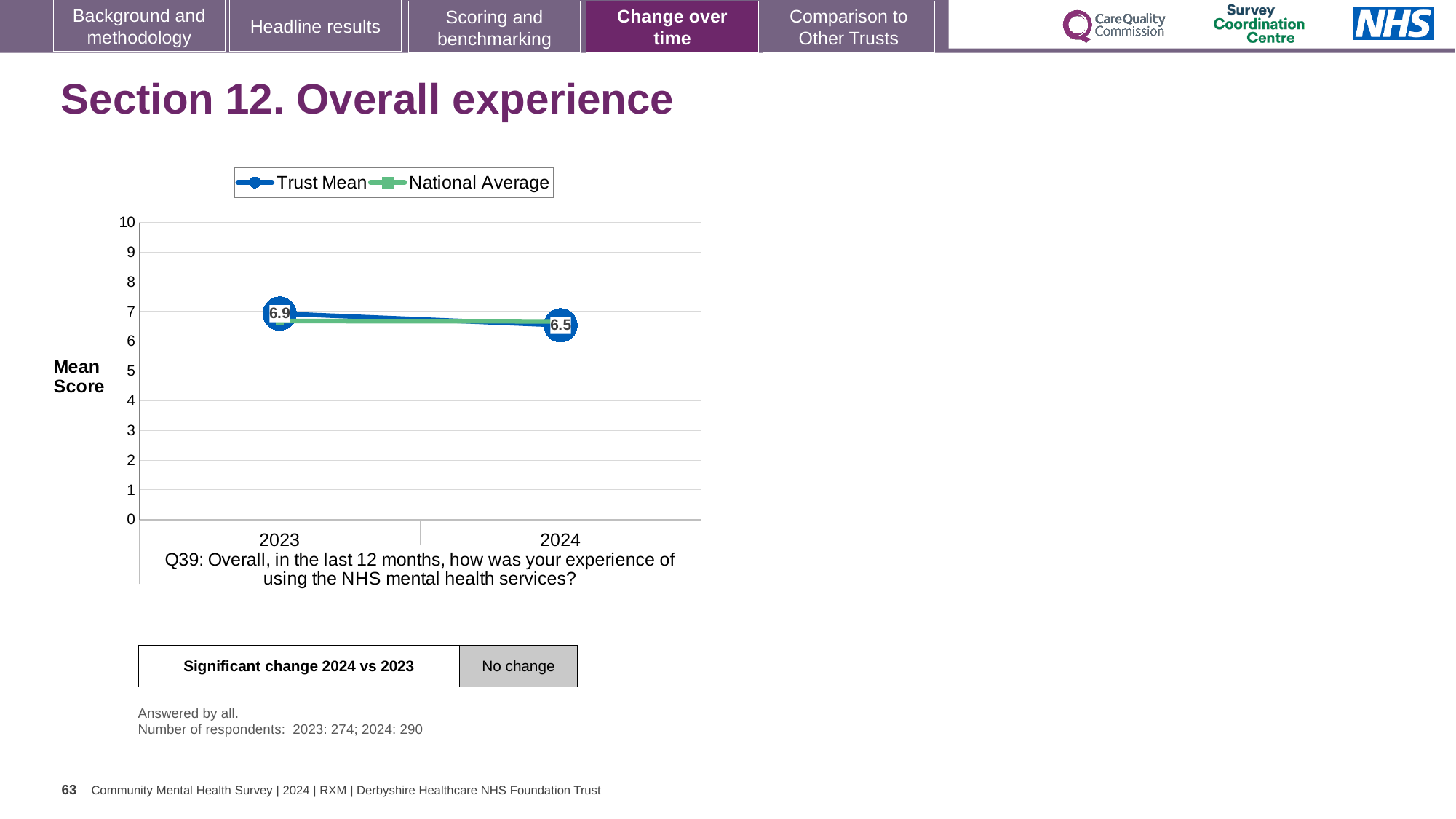
Is the National Average value for 2024 greater or less than 5? greater What is the Trust Mean value for 2023? 6.9 How many years are plotted on the x axis? 2 What kind of chart is shown on the slide? line chart Which year has the higher Trust Mean, 2023 or 2024? 2023 What is the Trust Mean value for 2024? 6.5 In which year is the Trust Mean highest? 2023 How many series does the legend list? 2 By how much did the Trust Mean change from 2023 to 2024? 0.4 Is the Trust Mean value for 2023 greater or less than 8? less Does the Trust Mean rise or fall from 2023 to 2024? fall What is the label on the y axis of the chart? Mean Score